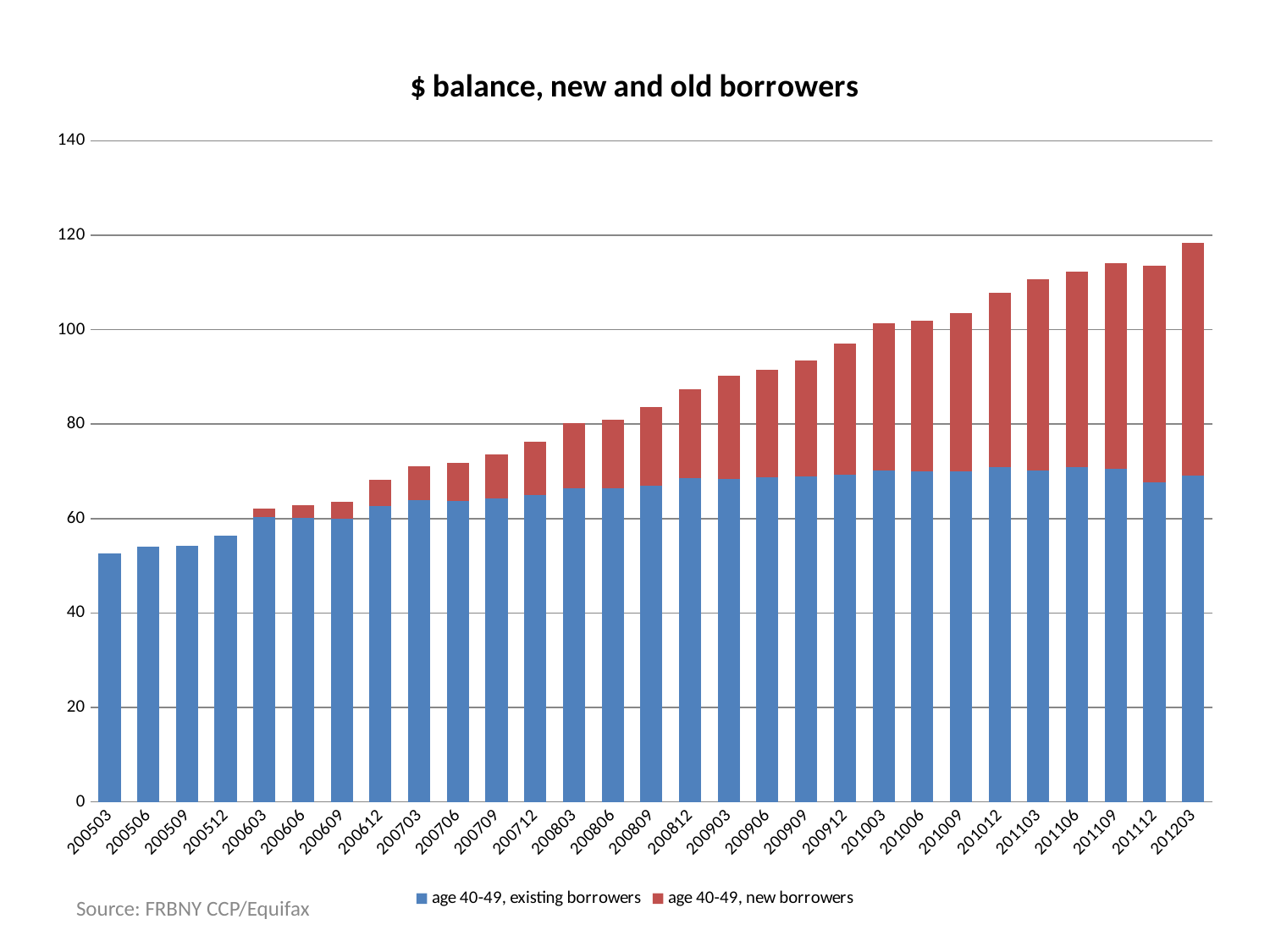
How many series does the legend list? 2 Is the total value for 200503 greater or less than 60? less Which period has the highest total stacked bar? 201203 Is the total stacked value for 200909 greater or less than 100? less What is the title of the chart? $ balance, new and old borrowers Is the value for age 40-49, existing borrowers in 201203 greater or less than 80? less What kind of chart is shown on the slide? bar chart Which series is shown in red? age 40-49, new borrowers Do the total bar heights generally rise or fall from 200503 to 201203? rise Which period has the lowest total stacked bar? 200503 How many time periods are shown along the x axis? 29